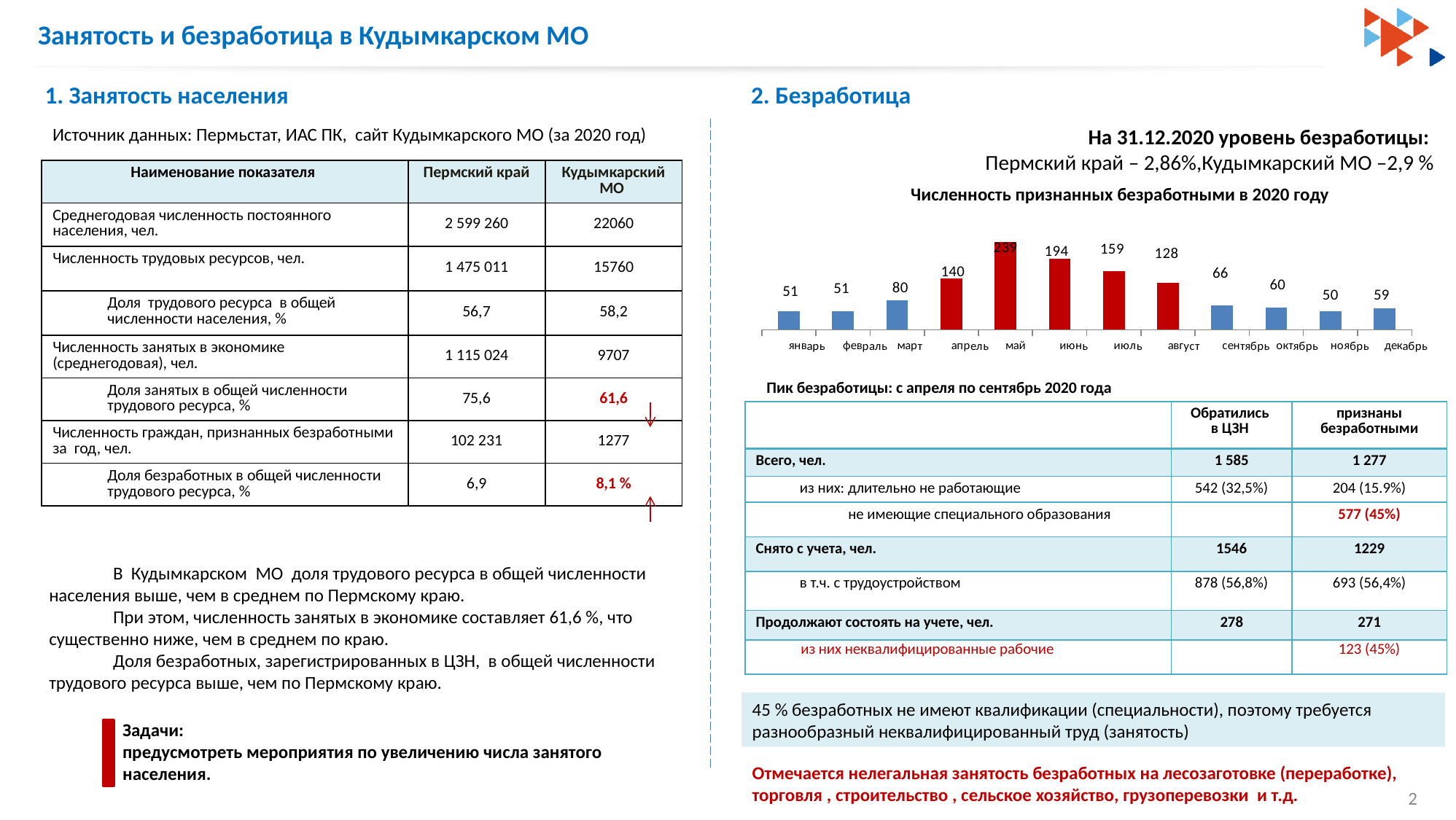
Which month has the highest value in the chart? май What type of chart is shown on the slide? bar chart What is the title of the chart on the slide? Численность признанных безработными в 2020 году Do the values rise or fall from май to август? fall Which is larger, the value for июль or the value for август? июль What is the difference between the values for май and июнь? 45 What is the value for ноябрь (November) in the chart? 50 Which month has the lowest value in the chart? ноябрь How many months (categories) are plotted in the chart? 12 Which months are shown with red bars in the chart? апрель, май, июнь, июль, август What is the value for май (May) in the chart? 239 What is the value for апрель (April) in the chart? 140